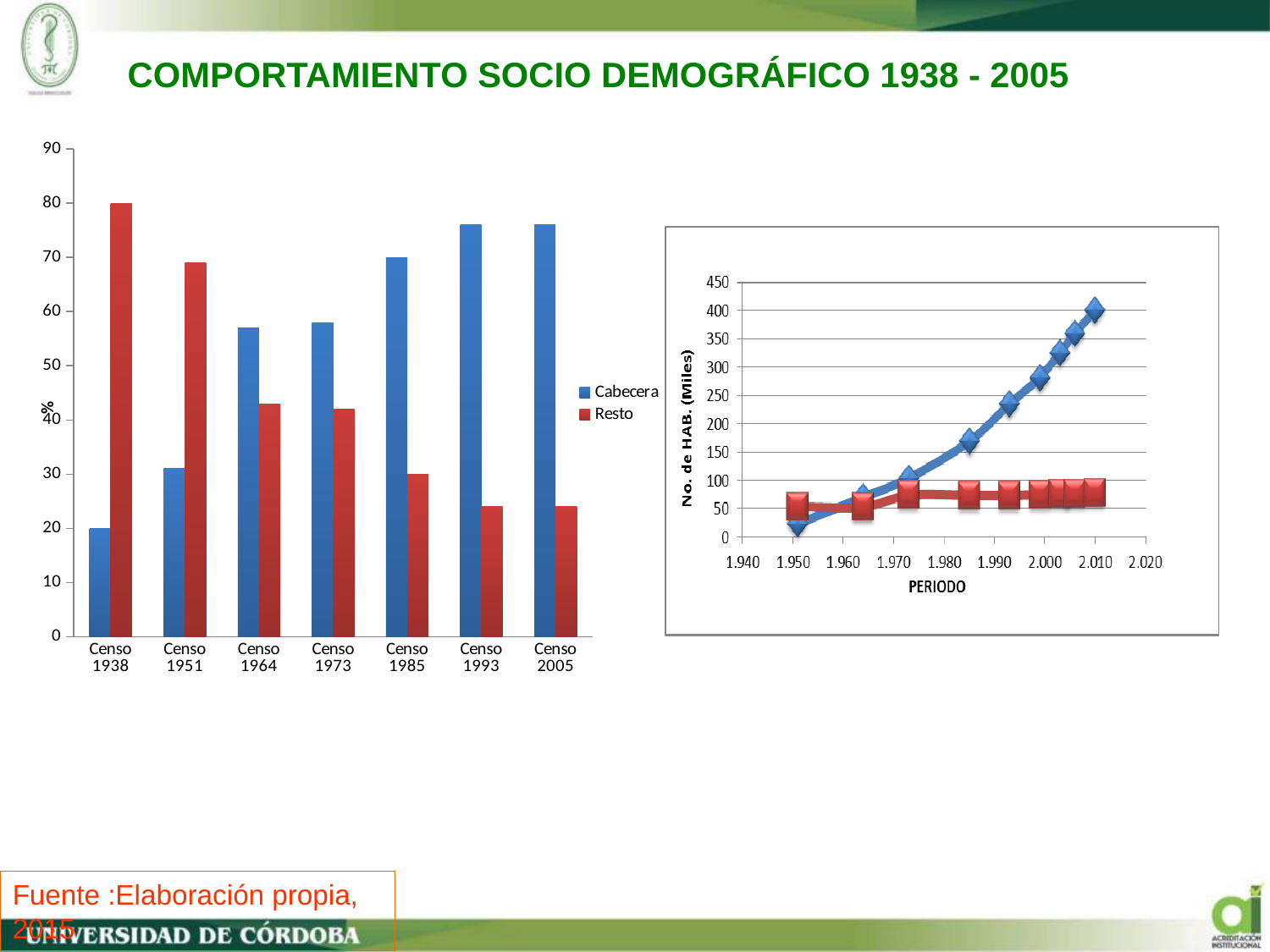
How many census categories are shown on the x axis of the left bar chart? 7 In the right chart, is the value of the blue series at 2.010 greater or less than 350? greater In the left bar chart, which is larger for Censo 1964, Cabecera or Resto? Cabecera How many series does the legend of the left bar chart list? 2 In the left bar chart, which census has the lowest Cabecera value? Censo 1938 In the left bar chart, what is the Cabecera value for Censo 1938? 20 What kind of chart is the left chart on the slide? bar chart In the left bar chart, what is the Cabecera value for Censo 1985? 70 In the left bar chart, which census has the highest Resto value? Censo 1938 In the left bar chart, does the Resto series rise or fall from Censo 1938 to Censo 2005? fall In the left bar chart, what is the Resto value for Censo 1938? 80